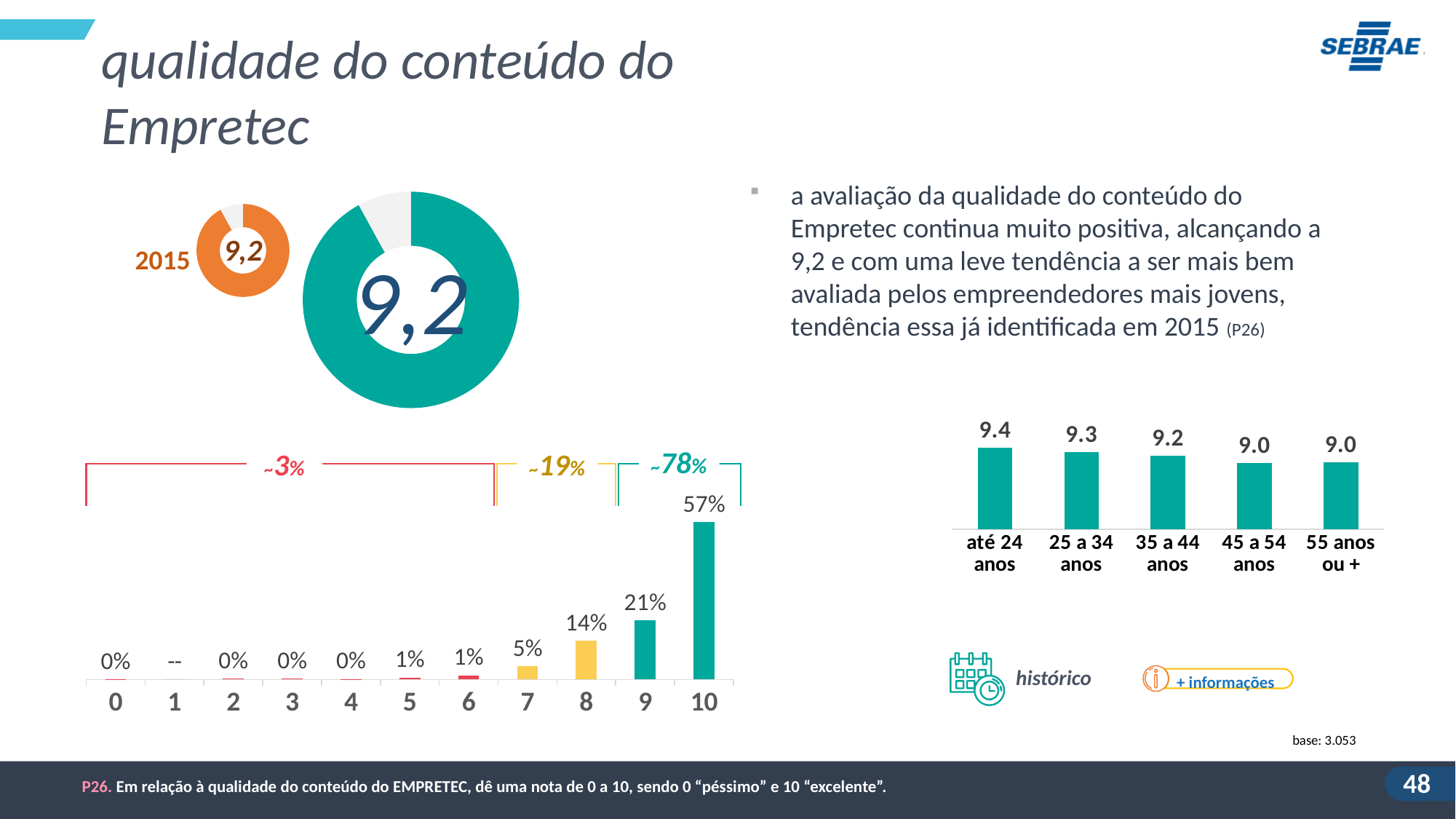
In the bar chart on the right, which age group has the highest value? até 24 anos In the bar chart at the bottom left, what percentage of respondents gave a score of 8? 14% In the bar chart at the bottom left, which is larger, the percentage for score 7 or for score 8? 8 In the bar chart at the bottom left, which score has the highest percentage? 10 In the bar chart on the right, what is the difference between the values for 'até 24 anos' and '45 a 54 anos'? 0.4 In the bar chart at the bottom left, what is the difference between the percentages for scores 10 and 9? 36% In the bar chart at the bottom left, what percentage of respondents gave a score of 10? 57% In the bar chart at the bottom left, what combined share is indicated by the bracket over scores 9 and 10? ~78% In the bar chart on the right, what is the value for 'até 24 anos'? 9.4 In the bar chart at the bottom left, how many score categories are shown on the x axis? 11 In the bar chart on the right, do the values rise or fall from the youngest to the oldest age group? fall What value is shown in the small orange donut chart labelled 2015? 9,2